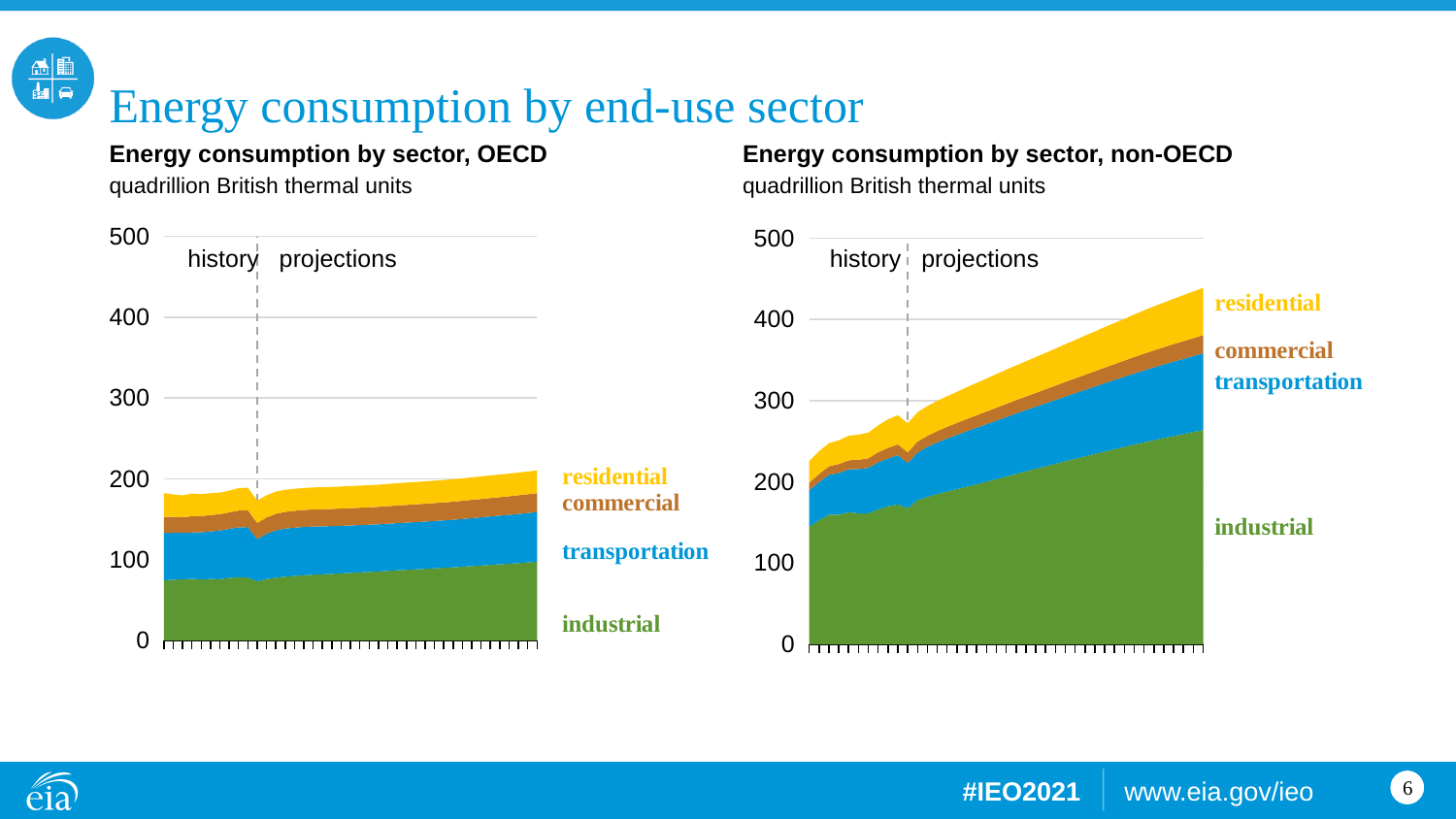
What kind of chart is the 'Energy consumption by sector, OECD' chart? stacked area chart At the end of the projection period, which chart shows higher total energy consumption: OECD or non-OECD? non-OECD In the 'Energy consumption by sector, non-OECD' chart, is the industrial sector's value at the end of the projection period greater or less than 200? greater In the 'Energy consumption by sector, OECD' chart, is the industrial sector's value at the start of the history period greater or less than 100? less In the 'Energy consumption by sector, non-OECD' chart, is the total energy consumption at the end of the projection period greater or less than 400? greater In the 'Energy consumption by sector, non-OECD' chart, which sector has the largest area? industrial How many sectors (series) are shown in the 'Energy consumption by sector, non-OECD' chart? 4 In the 'Energy consumption by sector, OECD' chart, which sector has the largest area? industrial What does the vertical dashed line in each chart separate? history and projections What unit is used on the y axis of both charts? quadrillion British thermal units In the 'Energy consumption by sector, non-OECD' chart, does total energy consumption rise or fall over the projection period? rise In the 'Energy consumption by sector, non-OECD' chart, which sector has the smallest area? commercial